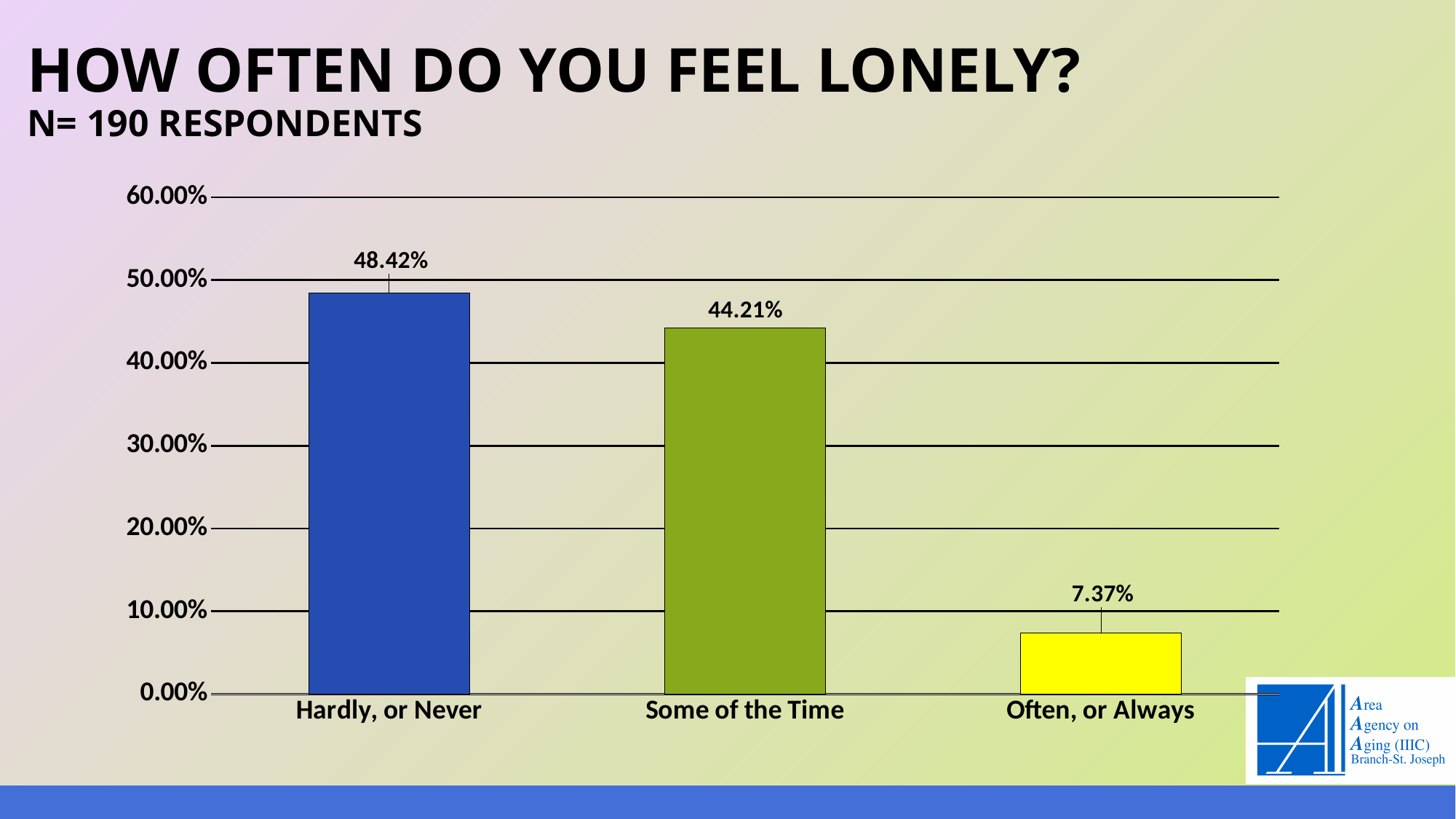
What percentage of respondents answered "Some of the Time"? 44.21% Which response category has the highest percentage? Hardly, or Never What percentage of respondents answered "Often, or Always"? 7.37% Which response category has the lowest percentage? Often, or Always Is the value for "Often, or Always" greater or less than 10.00%? less How many respondents does the slide say took part in the survey? 190 What percentage of respondents answered "Hardly, or Never"? 48.42% Which is larger: the value for "Some of the Time" or the value for "Often, or Always"? Some of the Time How many response categories are shown on the chart? 3 What is the difference in percentage points between "Hardly, or Never" and "Some of the Time"? 4.21% What kind of chart is shown on the slide? Bar chart What is the difference in percentage points between "Some of the Time" and "Often, or Always"? 36.84%